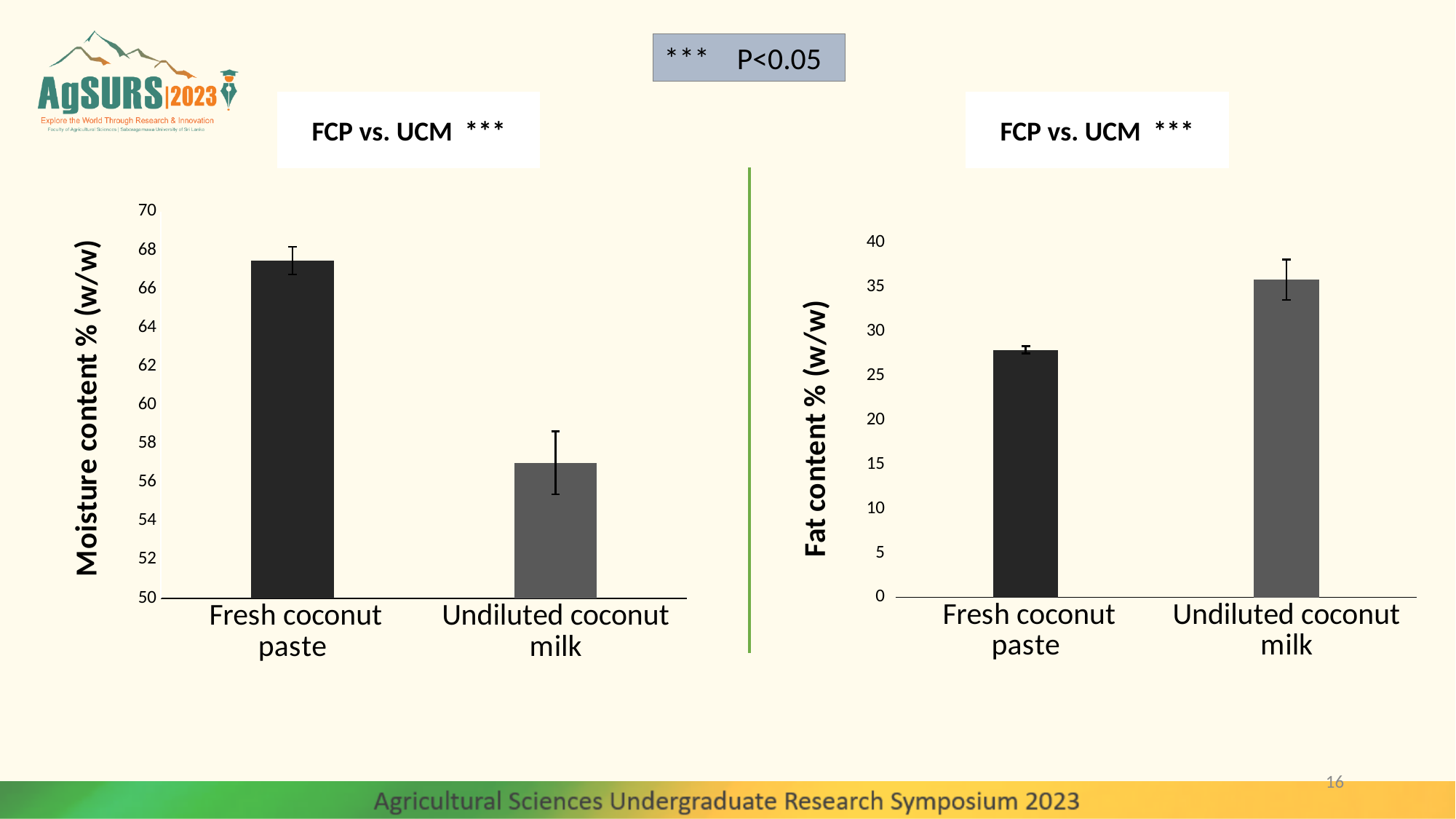
On the right chart (Fat content % (w/w)), is the value for Undiluted coconut milk greater or less than 30? greater On the left chart (Moisture content % (w/w)), is the value for Undiluted coconut milk greater or less than 58? less On the left chart (Moisture content % (w/w)), is the value for Fresh coconut paste greater or less than 66? greater How many categories are shown on the left chart (Moisture content % (w/w))? 2 On the right chart (Fat content % (w/w)), is the fat content of Fresh coconut paste larger or smaller than that of Undiluted coconut milk? smaller On the right chart (Fat content % (w/w)), which category has the lower fat content? Fresh coconut paste On the right chart (Fat content % (w/w)), which category has the higher fat content? Undiluted coconut milk What type of chart is the right chart (Fat content % (w/w))? bar chart What is the y-axis label of the left chart? Moisture content % (w/w) On the left chart (Moisture content % (w/w)), which category has the lower moisture content? Undiluted coconut milk On the left chart (Moisture content % (w/w)), which category has the higher moisture content? Fresh coconut paste